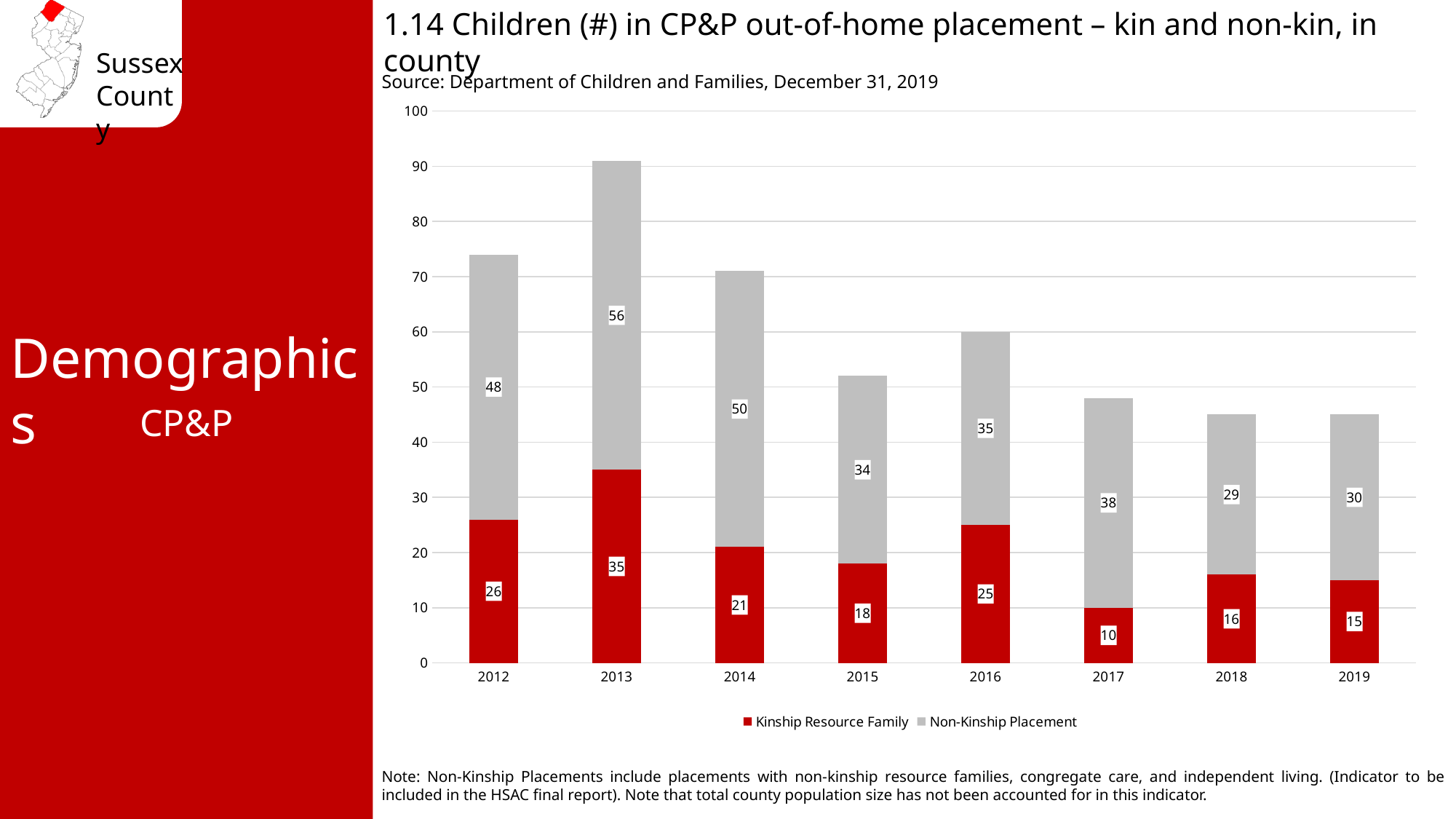
Which year has the highest Non-Kinship Placement value? 2013 What kind of chart is shown? stacked bar chart Which colour represents Kinship Resource Family in the chart? red Which year has the lowest Kinship Resource Family value? 2017 How many series does the legend list? 2 How many years are shown on the x axis? 8 Is the total stacked bar for 2013 greater or less than 90? greater Which is larger, the Kinship Resource Family value for 2016 or for 2018? 2016 What is the Kinship Resource Family value for 2013? 35 What is the Non-Kinship Placement value for 2017? 38 What is the total of the stacked bar for 2015? 52 What is the difference between the Non-Kinship Placement values for 2013 and 2019? 26